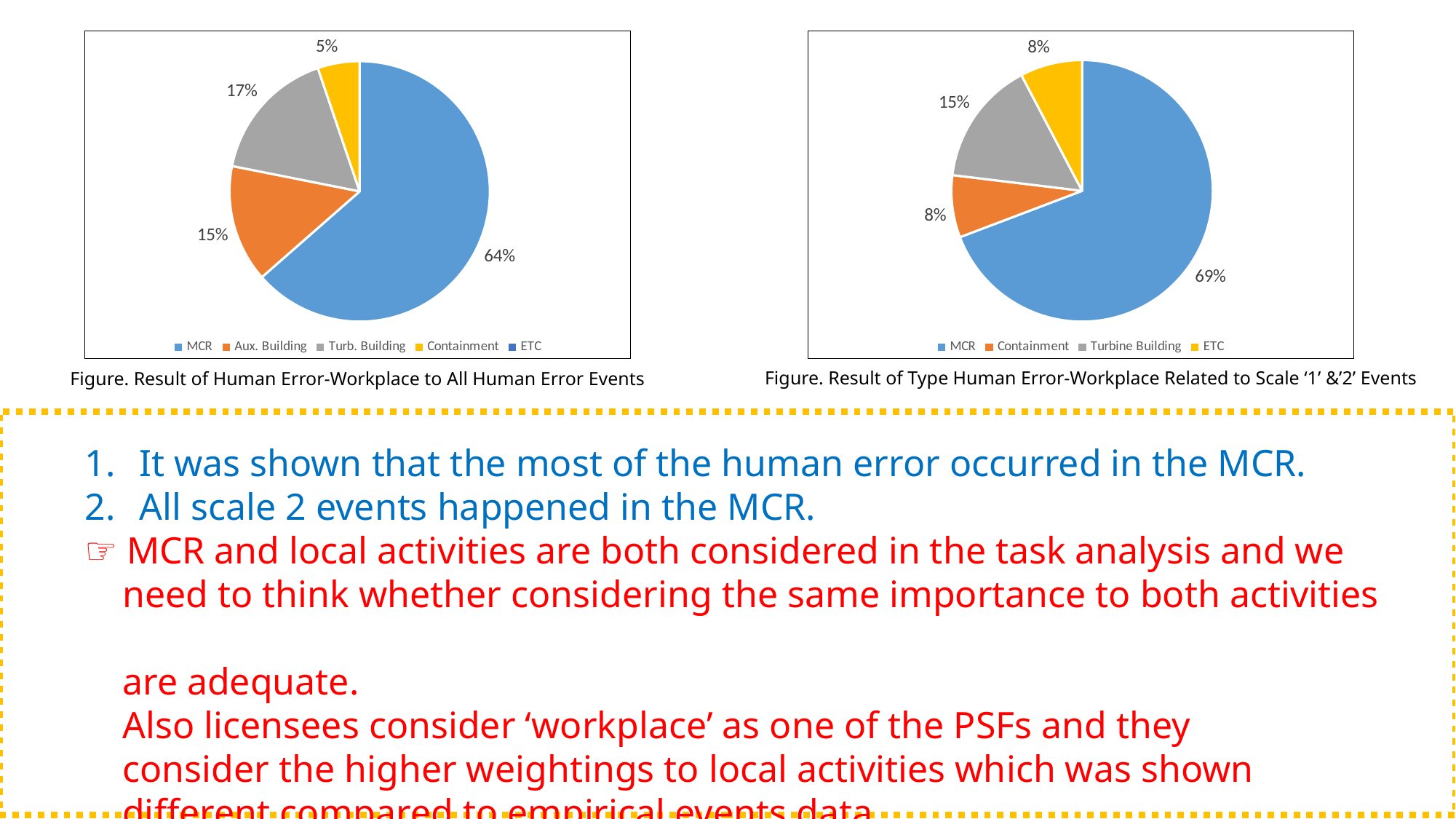
In the right pie chart (Result of Type Human Error-Workplace Related to Scale '1' & '2' Events), what share does MCR have? 69% How many entries does the legend of the right pie chart list? 4 In the left pie chart, what is the difference in percentage points between Turb. Building and Aux. Building? 2 In the right pie chart, which category has the largest slice? MCR In the left pie chart, which labelled slice is the smallest? Containment In the right pie chart, which is larger: the Turbine Building slice or the Containment slice? Turbine Building In the left pie chart, what percentage is shown for Containment? 5% In the right pie chart, what percentage is shown for Turbine Building? 15% In the right pie chart, what colour is the MCR slice? Blue What type of chart is used on the left side of the slide? Pie chart In the left pie chart, what percentage is shown for Turb. Building? 17% In the left pie chart (Result of Human Error-Workplace to All Human Error Events), what share does MCR have? 64%